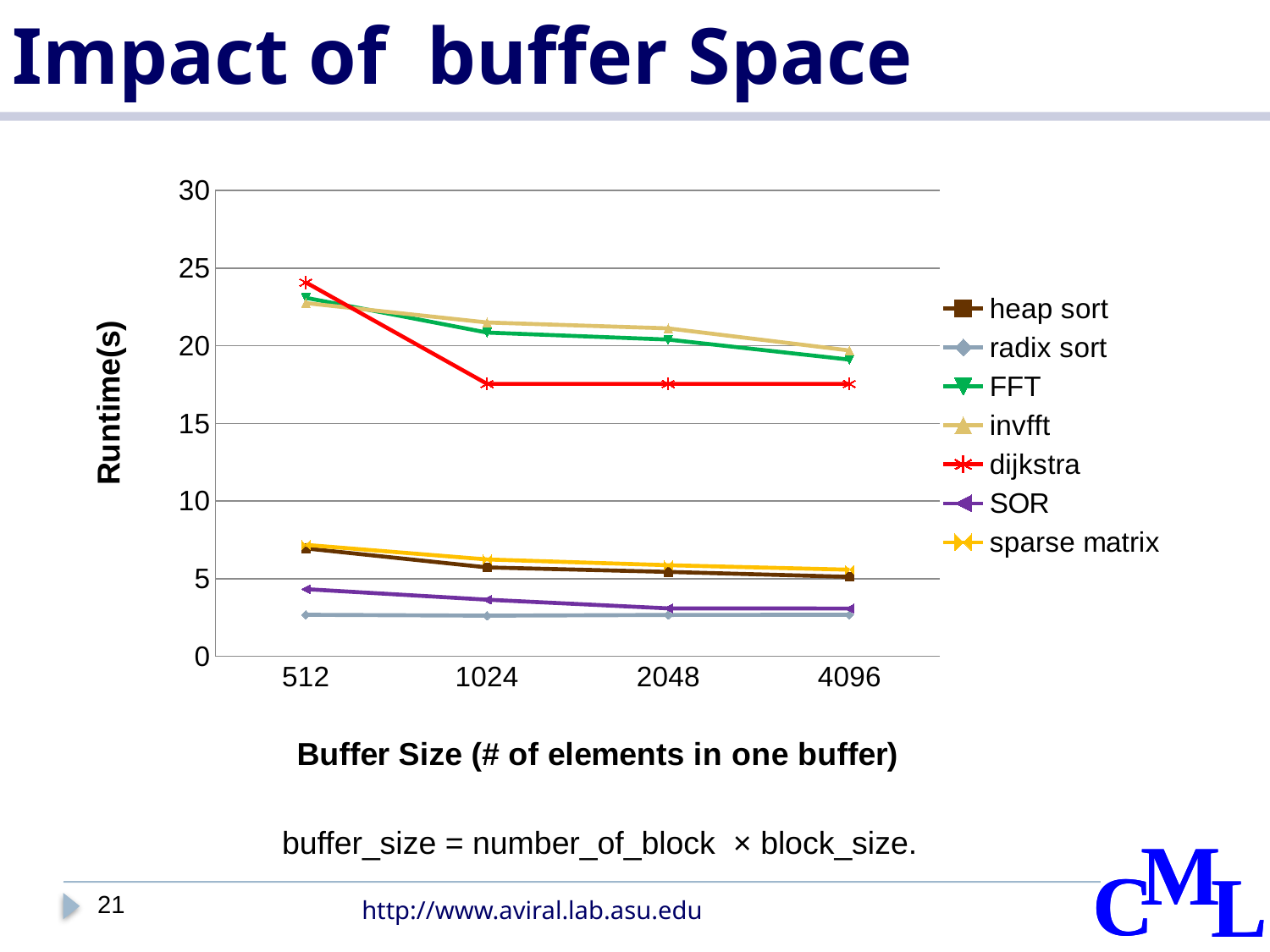
Which series has the highest runtime at buffer size 512? dijkstra At buffer size 2048, which has the larger runtime, FFT or dijkstra? FFT How many series does the legend list? 7 Is the runtime for dijkstra at buffer size 4096 greater or less than 20? less How many buffer sizes are plotted along the x axis? 4 At buffer size 512, which has the larger runtime, SOR or radix sort? SOR Does the runtime for dijkstra rise or fall as buffer size increases from 512 to 1024? fall Is the runtime for heap sort at buffer size 512 greater or less than 5? greater Which series has the lowest runtime across all buffer sizes? radix sort Is the runtime for dijkstra at buffer size 512 greater or less than 20? greater What kind of chart is shown on the slide? line chart What is the label of the y axis? Runtime(s)